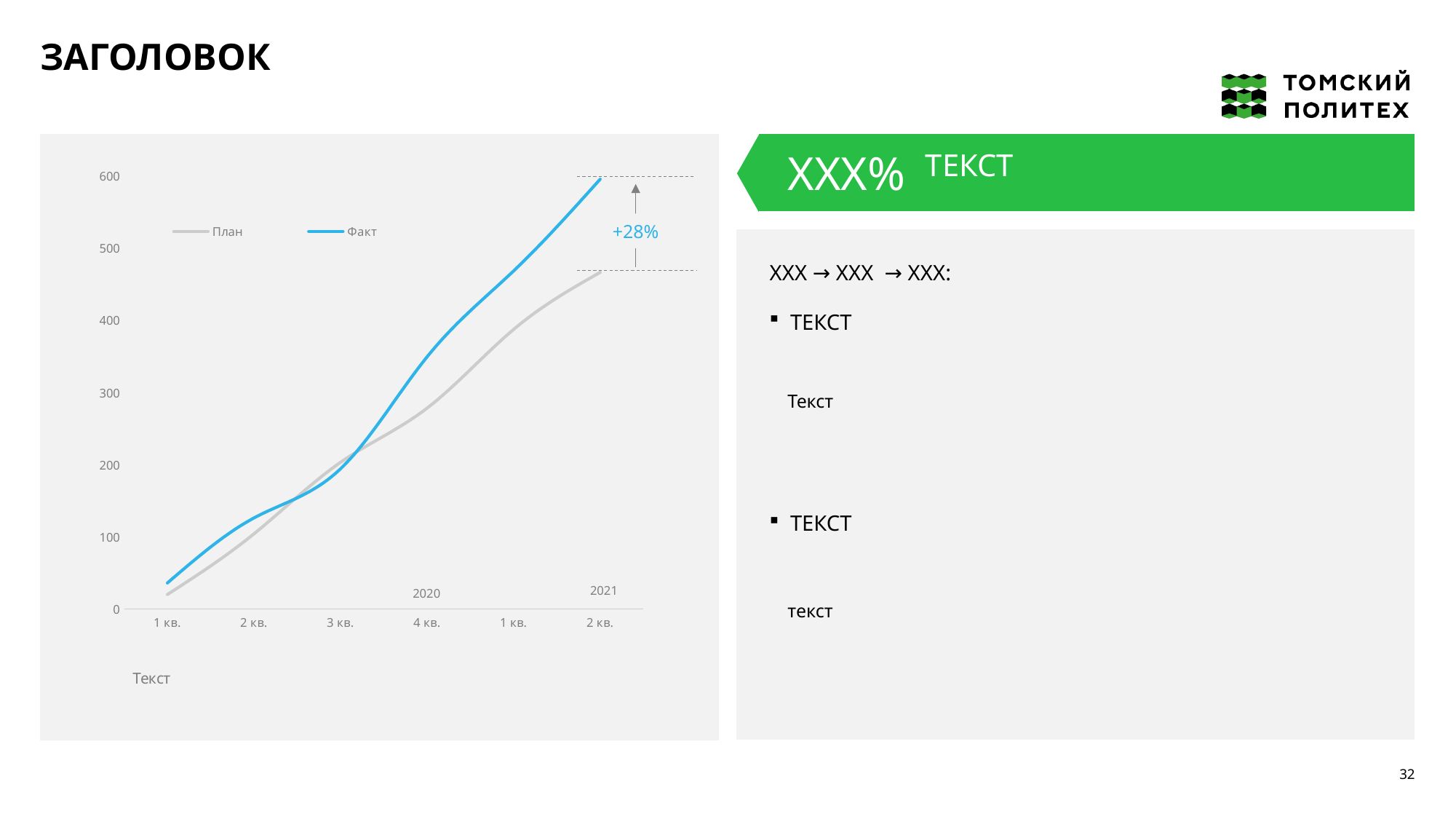
Is the value for План at 2 кв. 2021 greater or less than 500? less What percentage difference is annotated between the Факт and План lines at the end of the chart? +28% Is the value for Факт at 2 кв. 2021 greater or less than 500? greater Does the Факт line rise or fall from 1 кв. 2020 to 2 кв. 2021? rise How many quarter points are plotted along the x axis of the chart? 6 At 1 кв. 2021, which series has the higher value, План or Факт? Факт What kind of chart is shown on the slide? line chart What are the two series named in the chart legend? План and Факт How many series does the chart legend list? 2 Is the value for План at 4 кв. 2020 greater or less than 200? greater Does the План line rise or fall along the x axis? rise